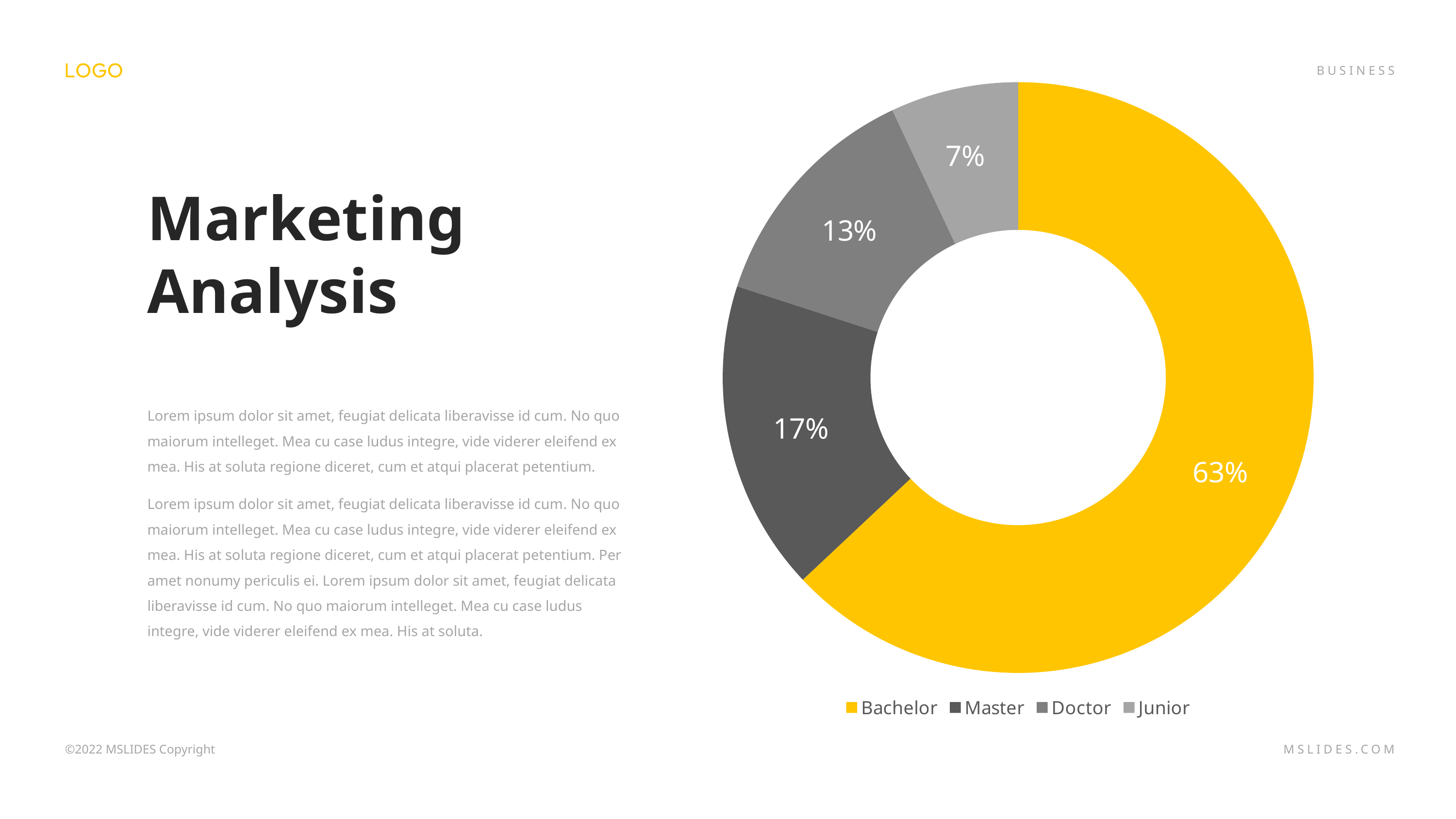
Which category has the largest share? Bachelor Which category has the smallest share? Junior What is the difference in percentage points between Bachelor and Master? 46 What share of the chart does Doctor represent? 13% What colour is the Bachelor slice? Yellow How many categories does the chart show? 4 What share of the chart does Junior represent? 7% What share of the chart does Master represent? 17% What is the difference in percentage points between Doctor and Junior? 6 Which is larger, the share for Master or the share for Doctor? Master What kind of chart is shown on the slide? Doughnut chart What share of the chart does Bachelor represent? 63%